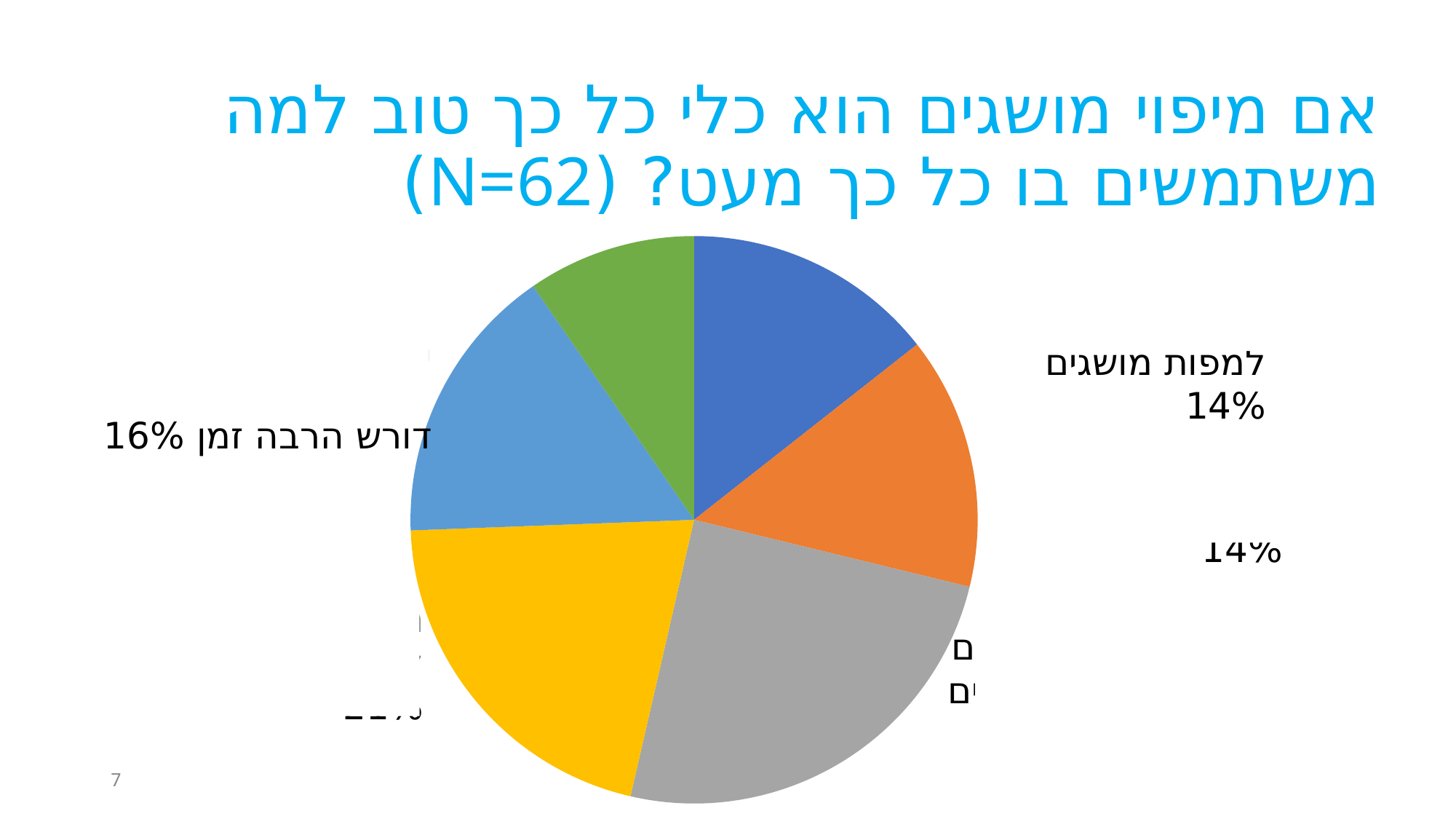
How many slices does the pie chart have? 6 Which is larger: the share for "דורש הרבה זמן" or the share for "למפות מושגים"? דורש הרבה זמן What sample size (N) is stated in the chart title? N=62 What kind of chart is shown on the slide? pie chart What share of the pie is labelled "למפות מושגים"? 14% What colour is the slice labelled "למפות מושגים"? blue What share of the pie is labelled "דורש הרבה זמן"? 16% What is the difference between the share for "דורש הרבה זמן" and the share for "למפות מושגים"? 2% Which colour slice is the largest in the pie chart? gray